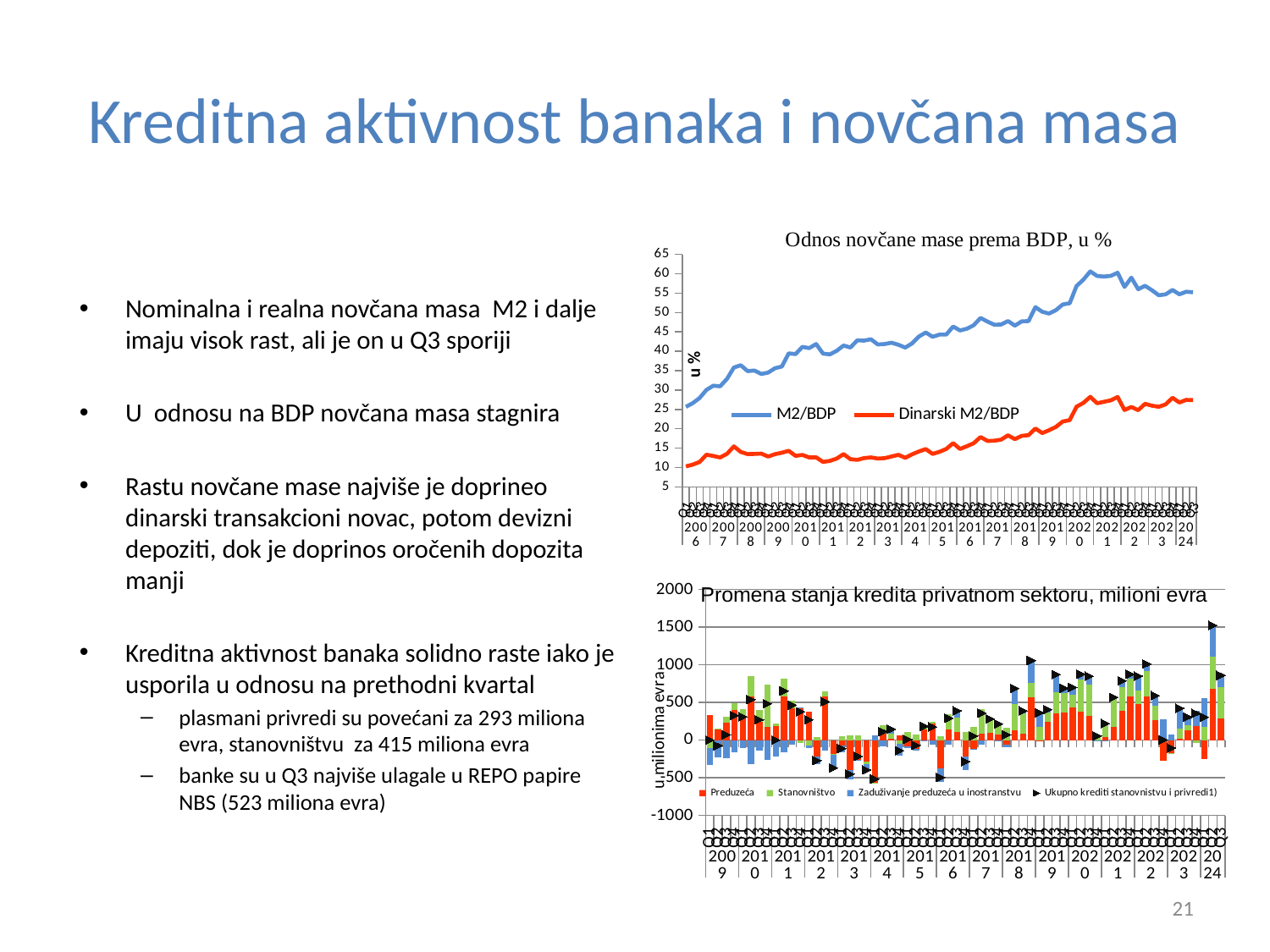
How many entries does the legend of the bottom chart "Promena stanja kredita privatnom sektoru, milioni evra" list? 4 What is the title of the top chart on the slide? Odnos novčane mase prema BDP, u % What kind of chart is the top chart titled "Odnos novčane mase prema BDP, u %"? line chart In the bottom chart "Promena stanja kredita privatnom sektoru, milioni evra", which colour represents the Preduzeća series? red What kind of chart is the bottom chart titled "Promena stanja kredita privatnom sektoru, milioni evra"? bar chart How many series does the legend of the top chart "Odnos novčane mase prema BDP, u %" list? 2 In the top chart "Odnos novčane mase prema BDP, u %", is the Dinarski M2/BDP value at the start of 2006 greater or less than 15? less In the top chart "Odnos novčane mase prema BDP, u %", which series is higher throughout the period, M2/BDP or Dinarski M2/BDP? M2/BDP In the top chart "Odnos novčane mase prema BDP, u %", is the M2/BDP value at the start of 2006 greater or less than 20? greater In the top chart "Odnos novčane mase prema BDP, u %", does the M2/BDP series overall rise or fall from 2006 to 2024? rise In the top chart "Odnos novčane mase prema BDP, u %", is the M2/BDP value at the end of 2024 greater or less than 50? greater